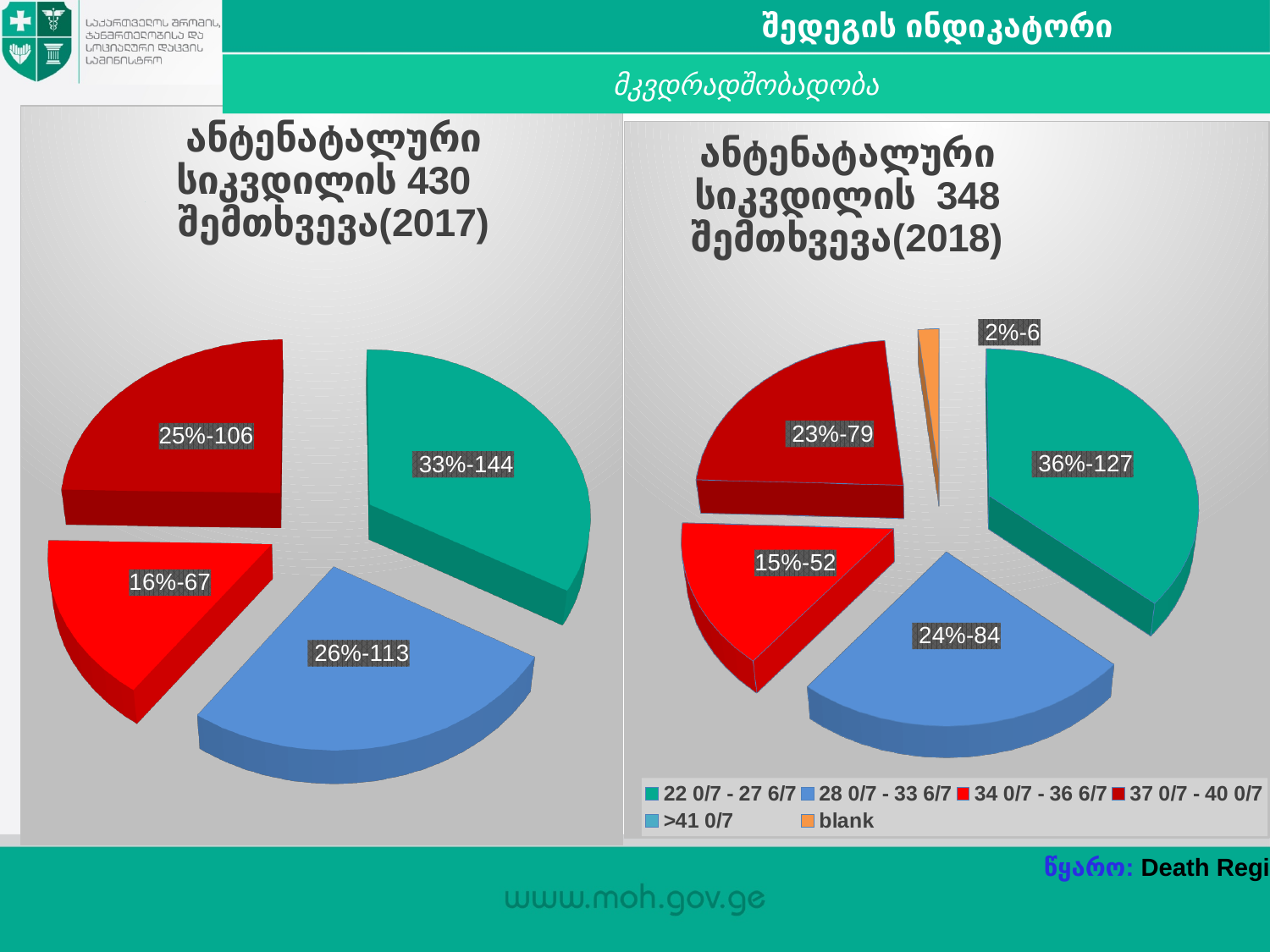
In the left pie chart (2017), what is the label on the teal slice for the 22 0/7 - 27 6/7 category? 33%-144 In the right pie chart (2018), what is the difference in count between the 22 0/7 - 27 6/7 slice and the 28 0/7 - 33 6/7 slice? 43 In the right pie chart (2018), what is the label on the orange 'blank' slice? 2%-6 How many entries does the legend below the right pie chart list? 6 In the left pie chart (2017), which category has the smallest slice? 34 0/7 - 36 6/7 In the right pie chart (2018), which category has the largest slice? 22 0/7 - 27 6/7 In the right pie chart (2018), what share of the pie does the 28 0/7 - 33 6/7 slice represent? 24% In the right pie chart (2018), which is larger: the 34 0/7 - 36 6/7 slice or the 37 0/7 - 40 0/7 slice? 37 0/7 - 40 0/7 What type of chart is shown on the left side of the slide (2017)? pie chart In the left pie chart (2017), what is the label on the blue slice for the 28 0/7 - 33 6/7 category? 26%-113 In the left pie chart (2017), what is the difference in count between the 37 0/7 - 40 0/7 slice and the 34 0/7 - 36 6/7 slice? 39 How many slices does the right pie chart (2018) have? 5